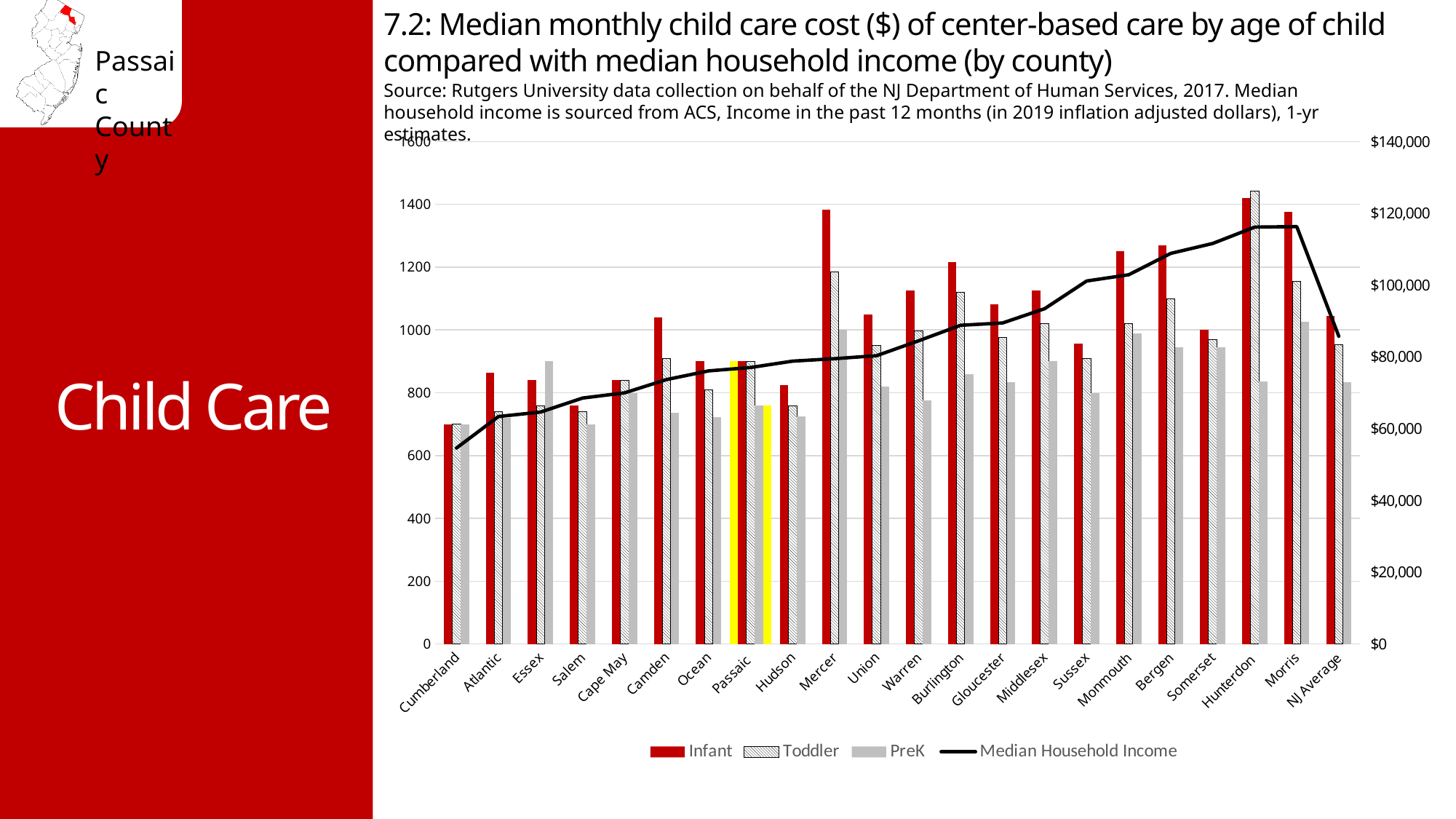
How many series does the legend list? 4 Is the Median Household Income for Cumberland greater or less than $60,000? less Is the Toddler value for Passaic greater or less than 800? greater Is the Infant value for Mercer greater or less than 1200? greater Which category has the highest Toddler value? Hunterdon Does the Median Household Income line generally rise or fall from Cumberland to Morris? rise Which category has the lowest Infant value? Cumberland How many categories are shown along the x axis? 22 Which is larger, the Infant value for Camden or the Infant value for Ocean? Camden Which category has the highest Infant value? Hunterdon What kind of chart is shown on the slide? Bar chart with a line